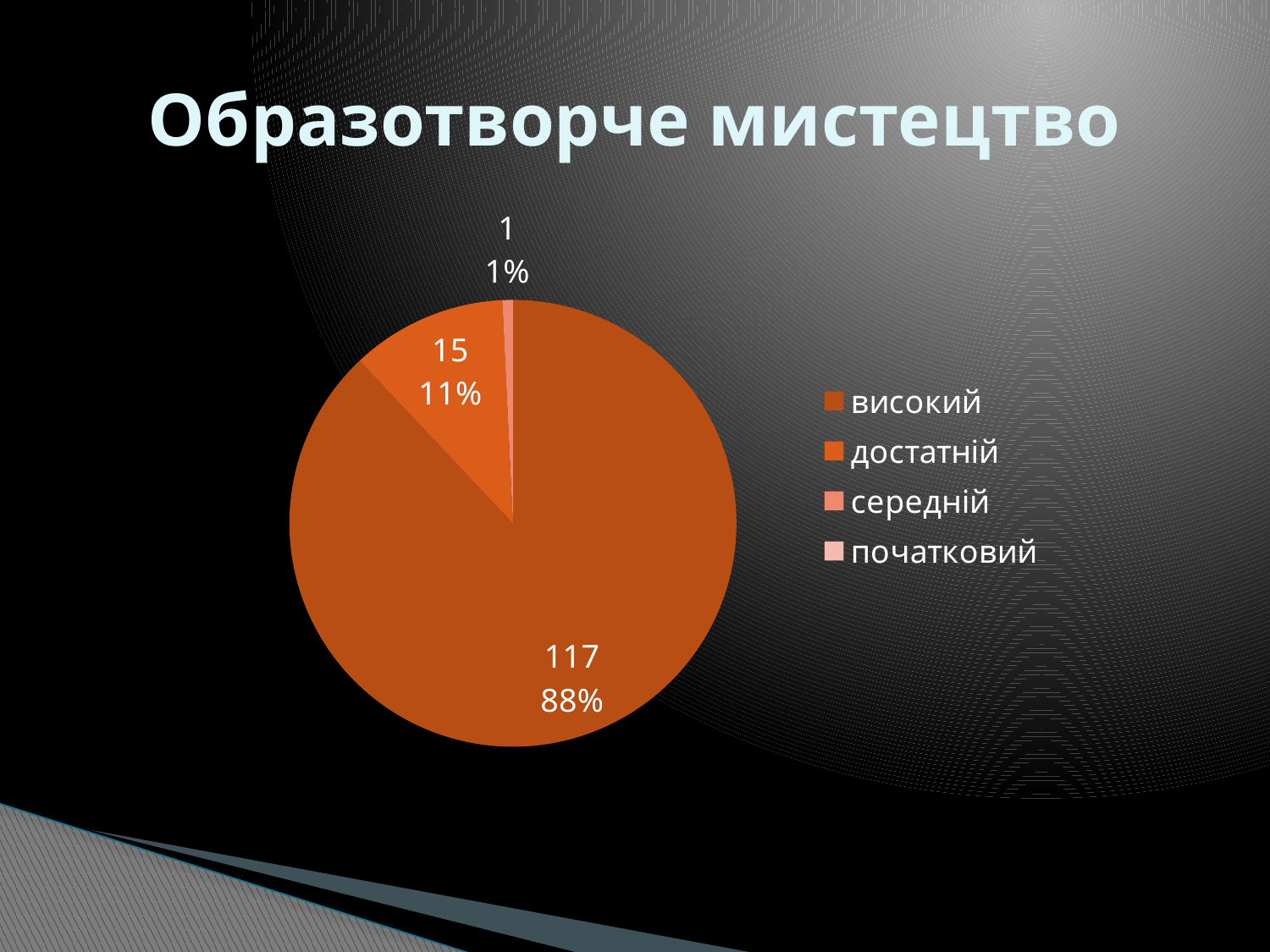
What is the value for достатній? 15 Which category has the largest slice? високий What is the difference between the values for високий and достатній? 102 What is the value for середній? 1 What share of the pie does середній take? 1% What share of the pie does високий take? 88% How many entries does the legend list? 4 What is the value for високий? 117 Which is larger, the value for достатній or the value for середній? достатній What is the title of the chart? Образотворче мистецтво What kind of chart is shown on the slide? pie chart What share of the pie does достатній take? 11%